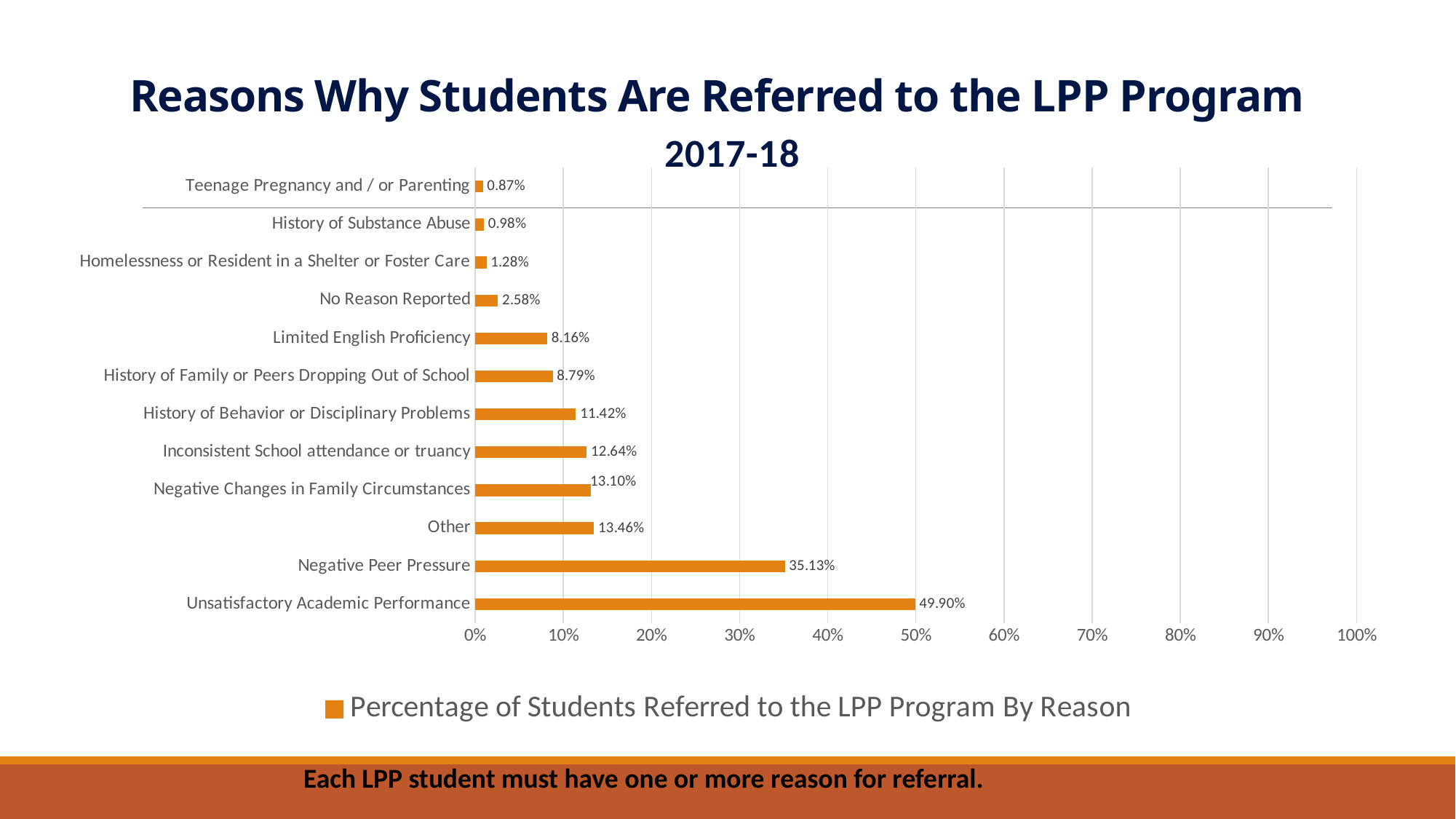
Which reason has the lowest percentage? Teenage Pregnancy and / or Parenting What kind of chart is shown on the slide? Bar chart What is the value for Teenage Pregnancy and / or Parenting? 0.87% Which reason has the highest percentage? Unsatisfactory Academic Performance How many reasons (categories) are shown in the chart? 12 What is the difference between Unsatisfactory Academic Performance and Negative Peer Pressure? 14.77% What is the legend entry for the series in the chart? Percentage of Students Referred to the LPP Program By Reason What percentage of students were referred for Unsatisfactory Academic Performance? 49.90% Is the value for Negative Peer Pressure greater or less than 30%? greater What is the value for Negative Peer Pressure? 35.13% Which is larger: Other or Inconsistent School attendance or truancy? Other What percentage is shown for Limited English Proficiency? 8.16%